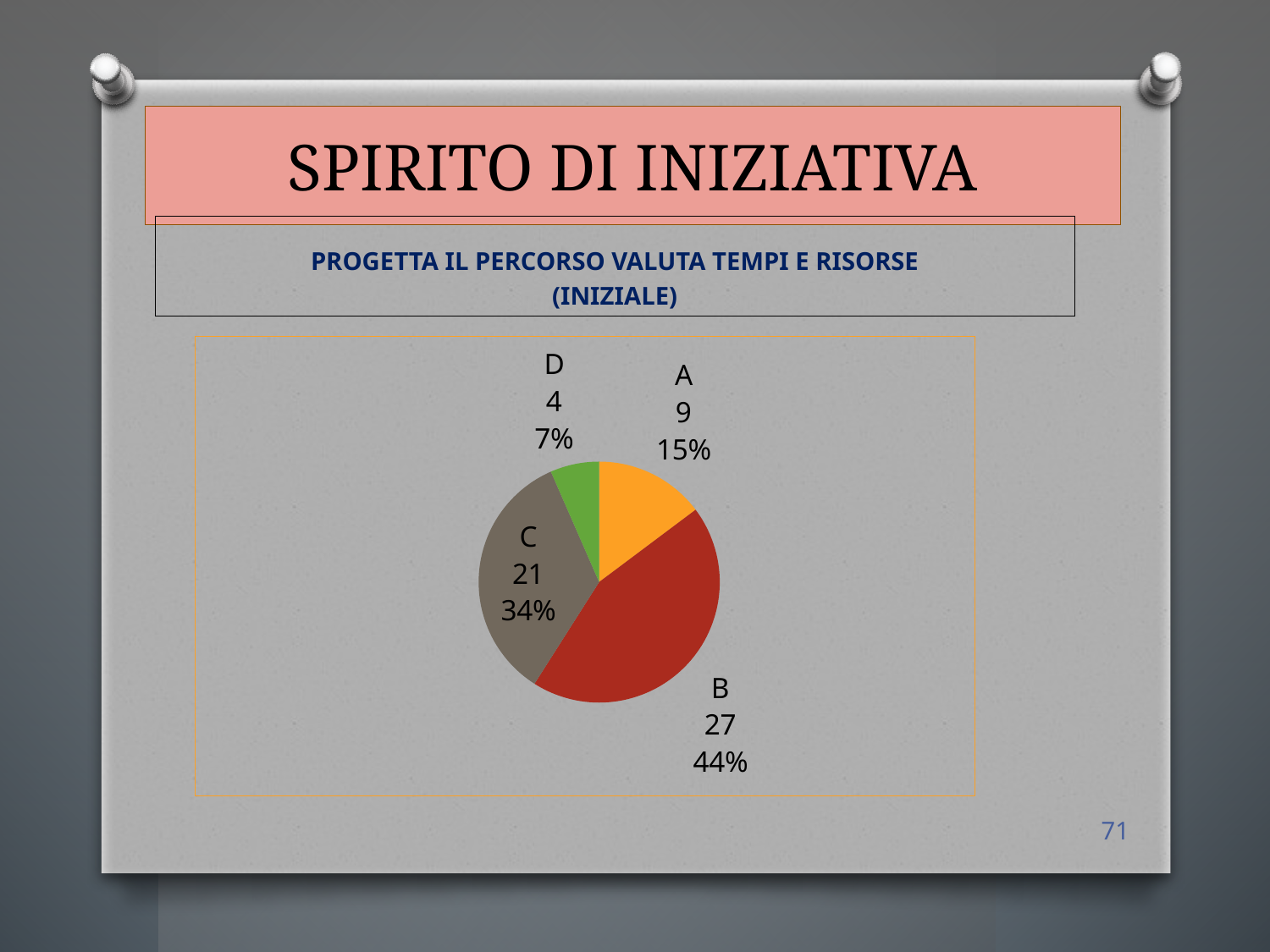
What is the total of all the slice values? 61 Which is larger, the value for A or the value for D? A What is the difference between the values for B and C? 6 Which category has the largest slice? B What kind of chart is shown on the slide? pie chart What percentage share does category C have? 34% What is the value for category A? 9 What percentage share does category D have? 7% What is the value for category B? 27 Which category has the smallest slice? D How many slices does the pie chart have? 4 What is the title shown above the pie chart? PROGETTA IL PERCORSO VALUTA TEMPI E RISORSE (INIZIALE)